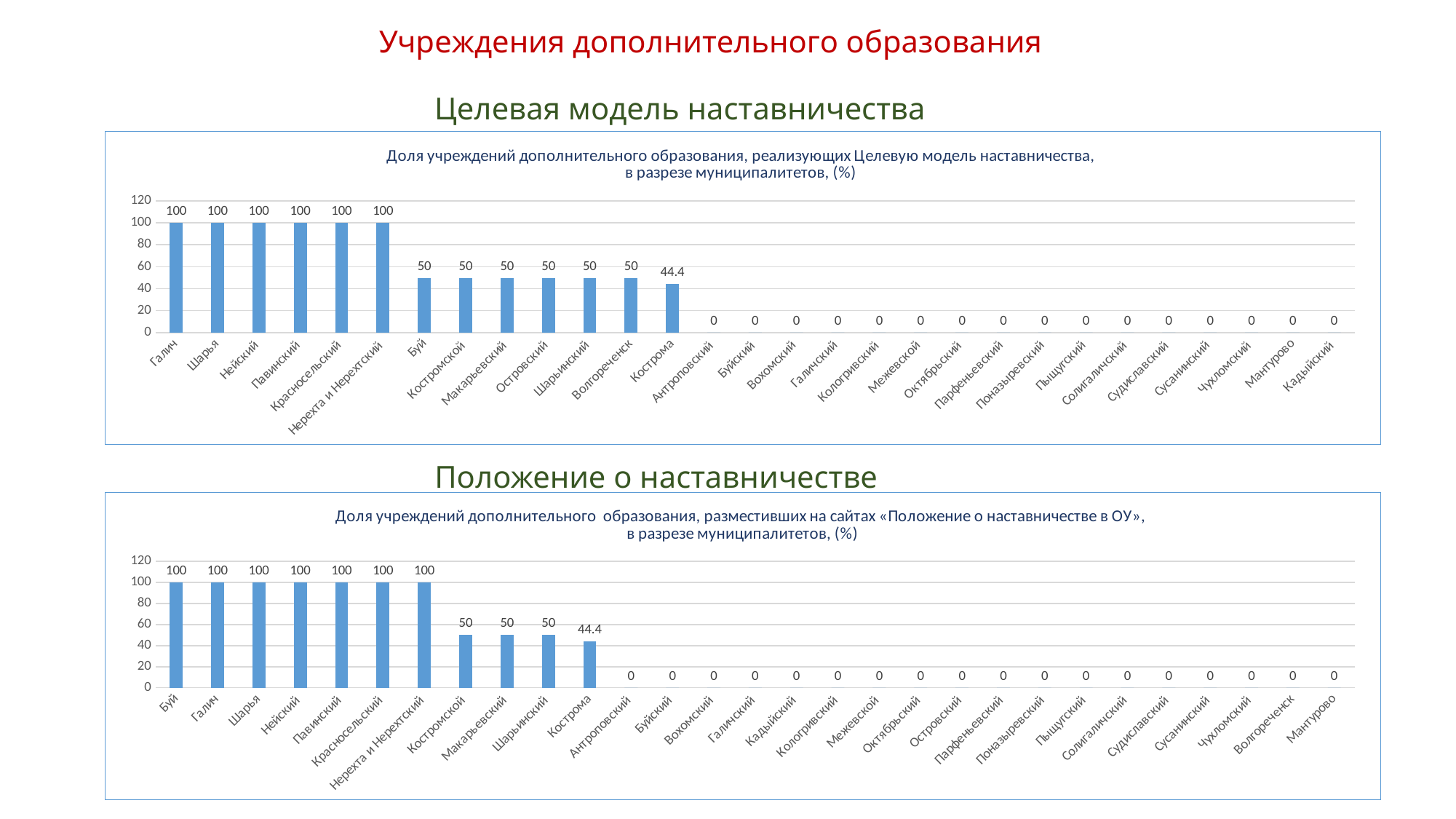
In the bottom chart (Положение о наставничестве), which is larger, the value for Костромской or the value for Кострома? Костромской In the top chart (Целевая модель наставничества), do the values rise or fall from left to right along the x axis? Fall In the top chart (Целевая модель наставничества), what is the value for Буй? 50 In the top chart (Целевая модель наставничества), what is the value for Кострома? 44.4 In the bottom chart (Положение о наставничестве), what is the value for Буй? 100 What is the main title at the top of the slide? Учреждения дополнительного образования In the top chart (Целевая модель наставничества), what is the difference between the values for Галич and Кострома? 55.6 In the bottom chart (Положение о наставничестве), what is the value for Волгореченск? 0 In the bottom chart (Положение о наставничестве), how many categories have a value of 100? 7 In the top chart (Целевая модель наставничества), which is larger, the value for Волгореченск or the value for Островский? They are equal (50) How many categories are shown on the x axis of the bottom chart (Положение о наставничестве)? 29 What kind of chart is the top chart (Целевая модель наставничества)? Bar chart